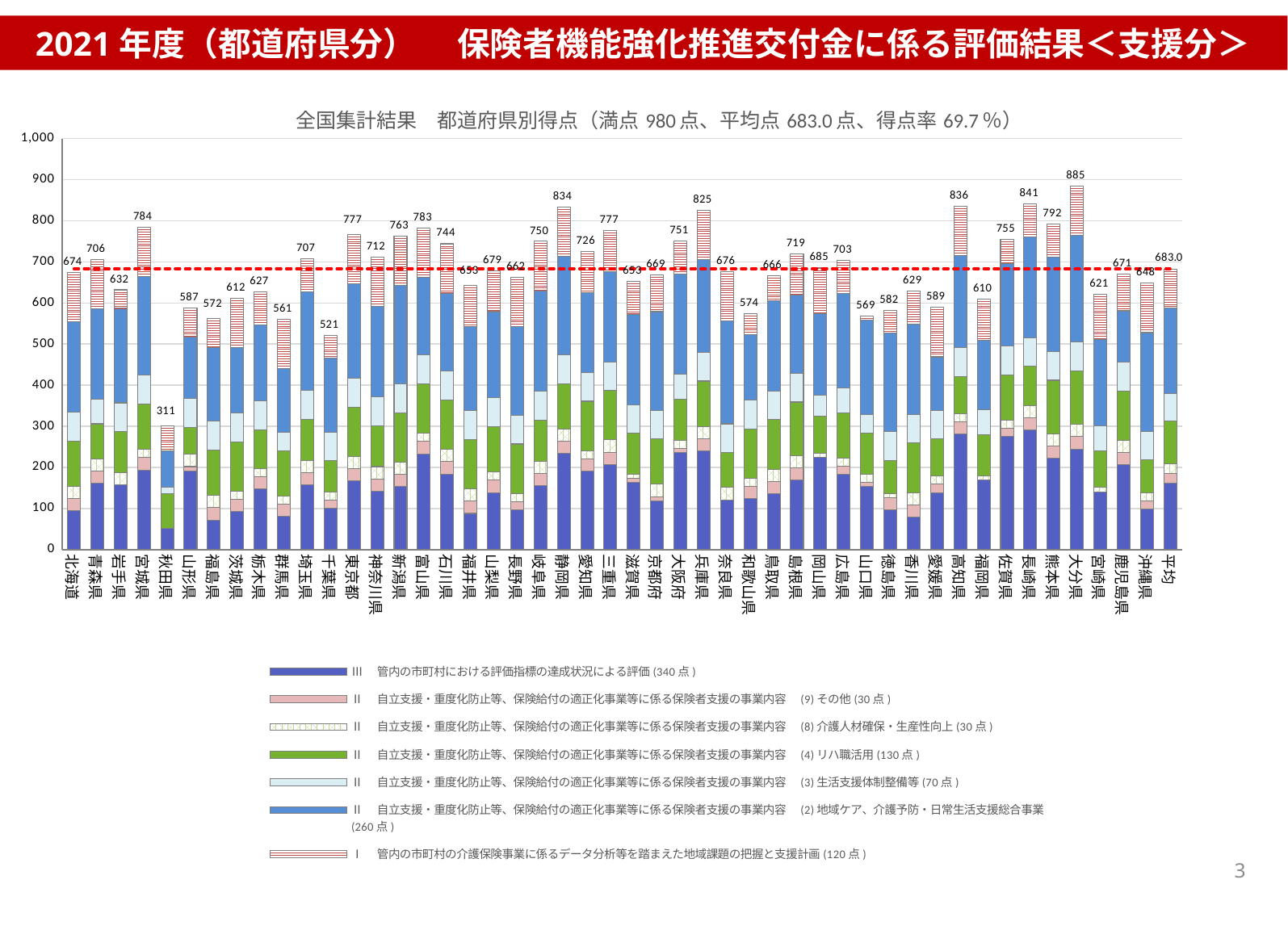
Is the total score for 千葉県 greater or less than 600? less How many series does the legend list? 7 What is the total score shown for 秋田県? 311 What is the value shown for 平均 (the average bar)? 683.0 What is the difference between the total scores of 静岡県 and 愛知県? 108 Which has a higher total score, 宮城県 or 東京都? 宮城県 Which prefecture has the highest total score? 大分県 What kind of chart is shown on the slide? stacked bar chart Which prefecture has the lowest total score? 秋田県 What is the total score shown for 大分県? 885 What is the average score (平均点) stated in the chart title? 683.0 点 How many bars are plotted in the chart, including the 平均 bar? 48